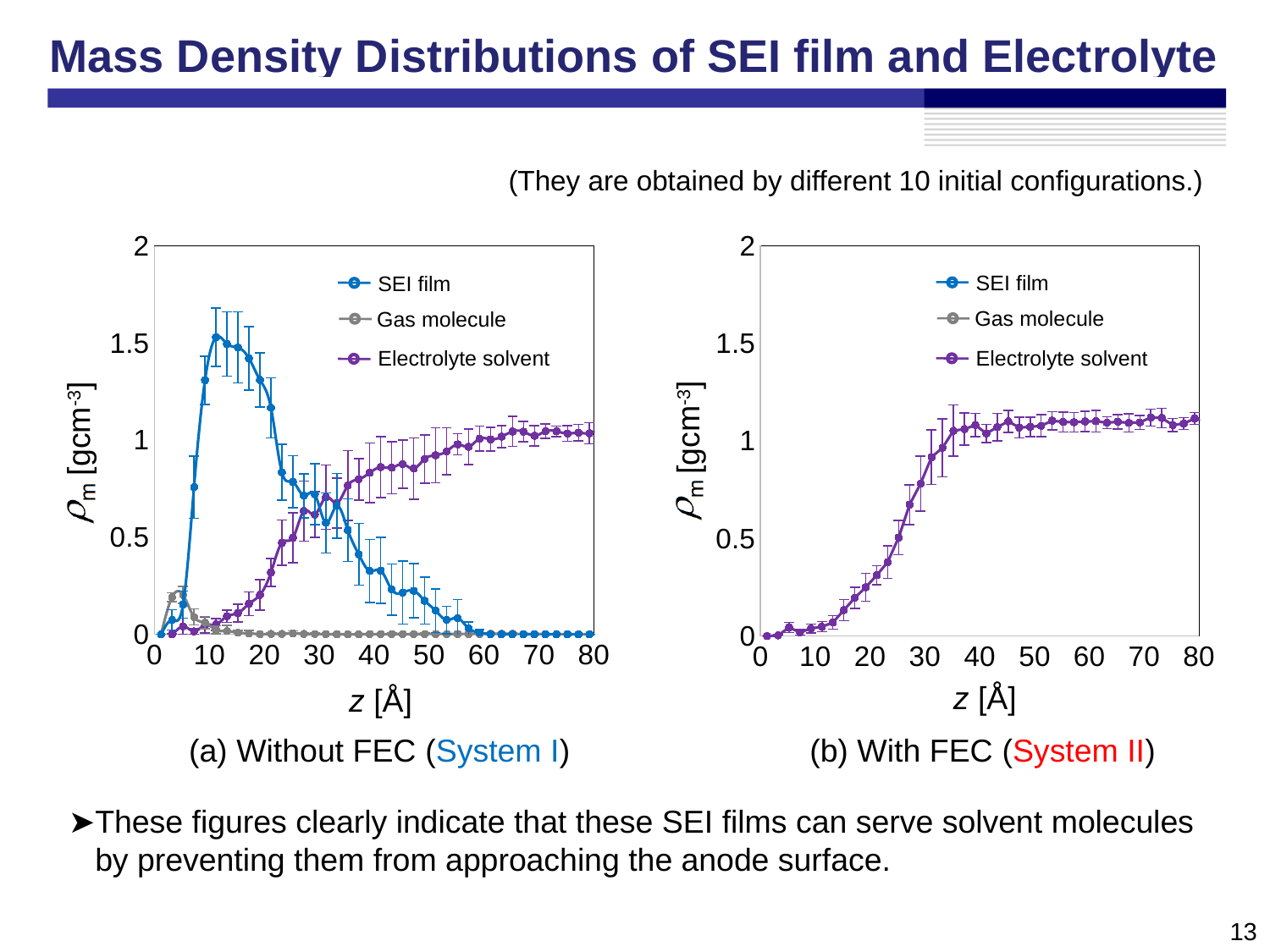
In panel (a) Without FEC (System I), does the SEI film curve rise or fall as z increases from 20 to 60 Å? fall In panel (b) With FEC (System II), is the Electrolyte solvent value at z = 10 Å greater or less than 0.5? less How many series does the legend list in panel (b) With FEC (System II)? 3 In panel (a) Without FEC (System I), which is larger at z = 10 Å: SEI film or Electrolyte solvent? SEI film In panel (a) Without FEC (System I), is the Electrolyte solvent value at z = 70 Å greater or less than 0.5? greater In panel (b) With FEC (System II), does the Electrolyte solvent curve rise or fall as z increases from 10 to 40 Å? rise In panel (a) Without FEC (System I), is the SEI film value at z = 10 Å greater or less than 1? greater What kind of chart is shown in panel (a) Without FEC (System I)? line chart In panel (a) Without FEC (System I), which is larger at z = 60 Å: SEI film or Electrolyte solvent? Electrolyte solvent What is the x-axis label of the chart in panel (b) With FEC (System II)? z [Å] In panel (a) Without FEC (System I), which series reaches the highest peak value? SEI film